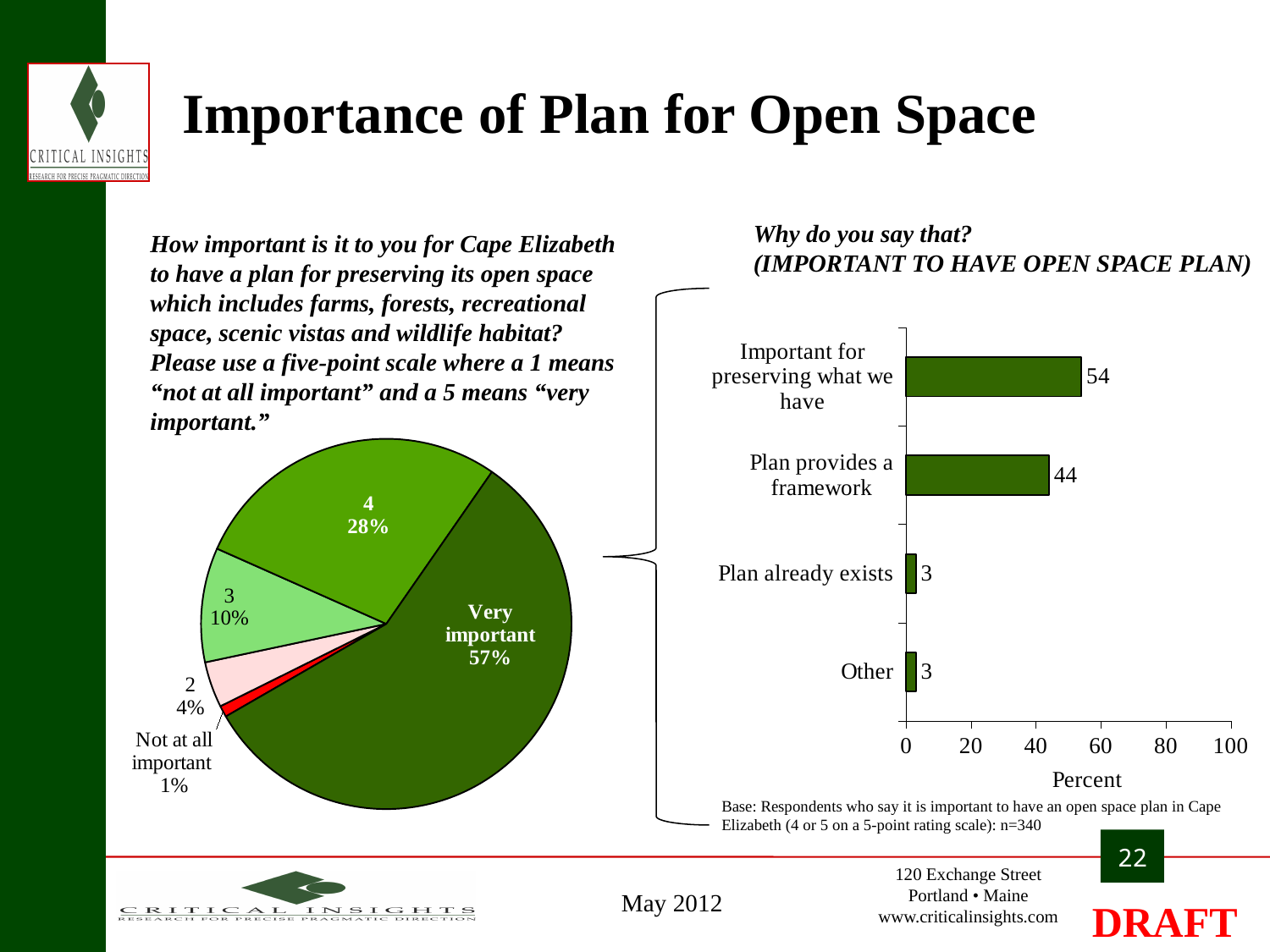
In the pie chart on the left, what percentage of respondents gave a rating of 3? 10% What type of chart is the chart on the right of the slide? Bar chart In the bar chart on the right, what is the difference between "Important for preserving what we have" and "Plan provides a framework"? 10 In the bar chart on the right, which reason has the highest value? Important for preserving what we have In the bar chart on the right, which is larger: "Plan provides a framework" or "Plan already exists"? Plan provides a framework How many slices does the pie chart on the left have? 5 In the pie chart on the left, what percentage of respondents said a plan for open space is "Very important"? 57% In the pie chart on the left, how many percentage points larger is the "Very important" share than the share for rating 4? 29 percentage points In the pie chart on the left, which rating has the largest share? Very important In the bar chart on the right, what is the value for "Plan provides a framework"? 44 How many categories are shown in the bar chart on the right? 4 In the pie chart on the left, which rating has the smallest share? Not at all important